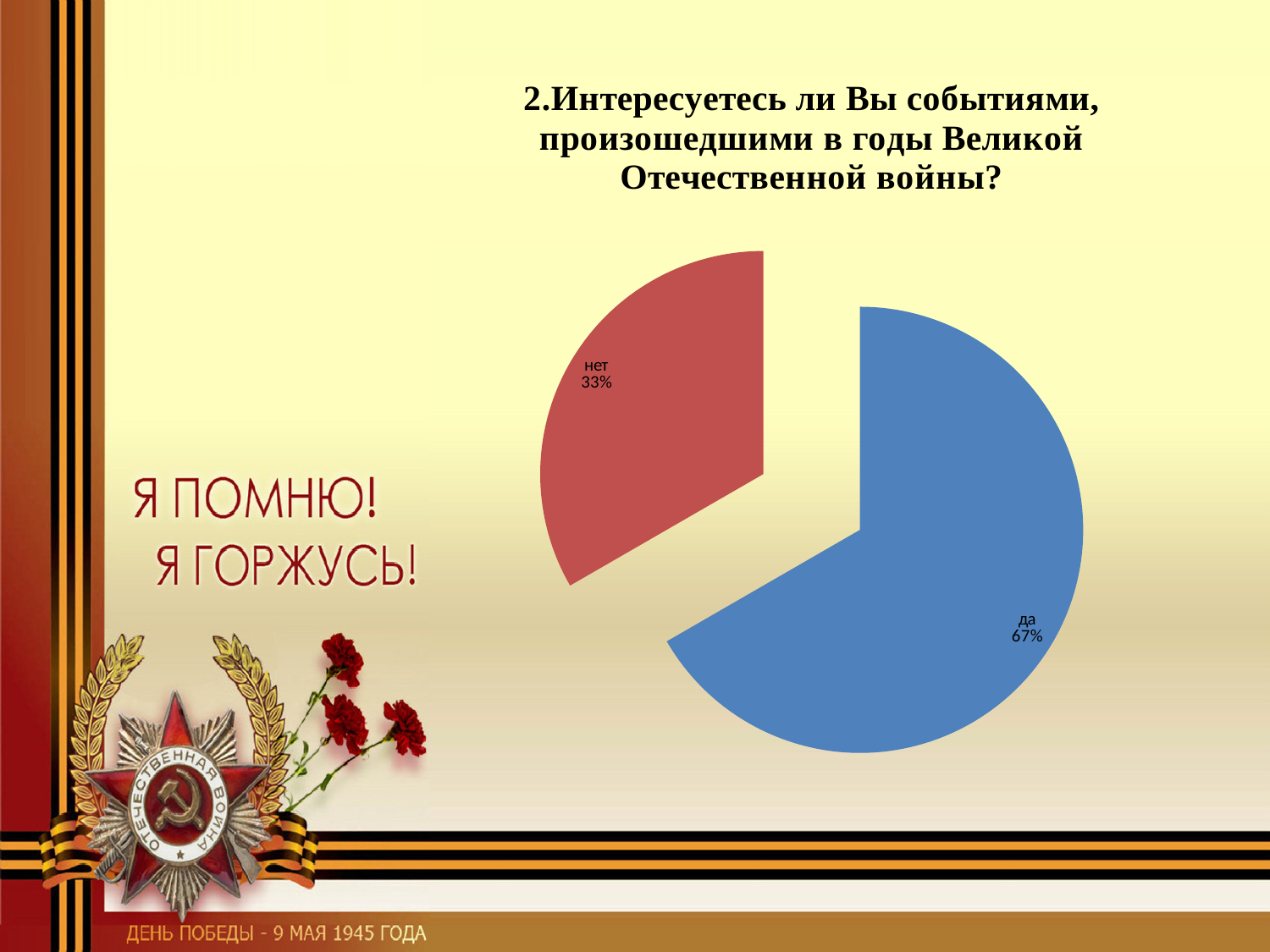
Which slice of the pie is the smallest? нет What share of the pie does the "да" slice represent? 67% What share of the pie does the "нет" slice represent? 33% Which slice of the pie is the largest? да How many slices does the pie chart have? 2 What is the difference in percentage points between the "да" and "нет" slices? 34 Which is larger, the "да" slice or the "нет" slice? да What kind of chart is shown on the slide? pie chart What colour is the "да" slice? blue What is the total of the two slice percentages shown on the pie chart? 100% What colour is the "нет" slice? red